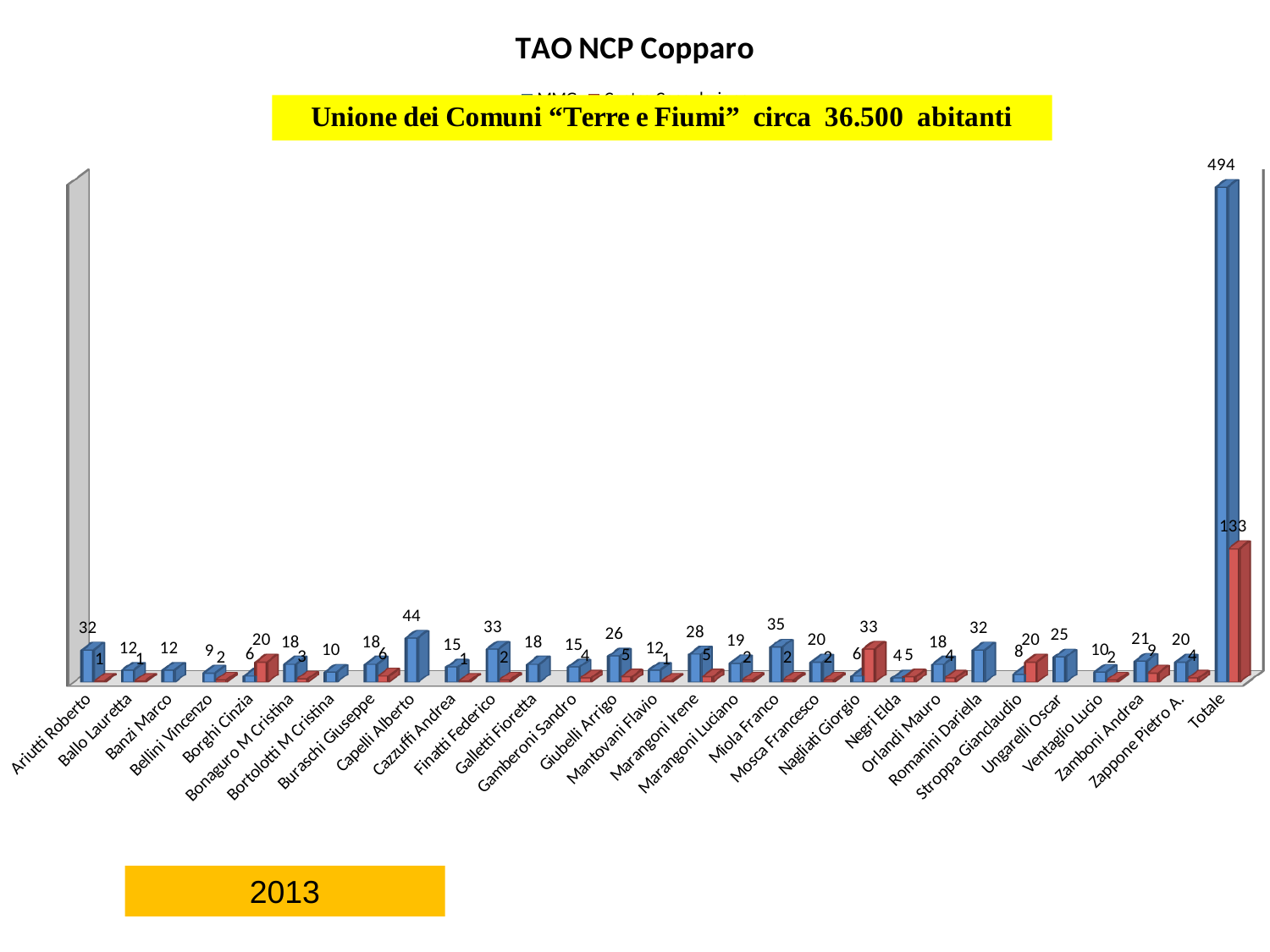
What is the difference between the red and blue bars for Borghi Cinzia? 14 What is the value of the blue bar for Capelli Alberto? 44 Excluding Totale, which category has the highest blue bar? Capelli Alberto What is the value of the red bar for Totale? 133 What is the title of the chart? TAO NCP Copparo Which is larger, the blue bar for Miola Franco or the blue bar for Finatti Federico? Miola Franco What is the value of the red bar for Nagliati Giorgio? 33 How many categories are shown on the x axis, including Totale? 29 What is the value of the blue bar for Romanini Dariella? 32 What is the value of the blue bar for Totale? 494 What is the difference between the blue and red bars for Totale? 361 What kind of chart is shown on the slide? bar chart